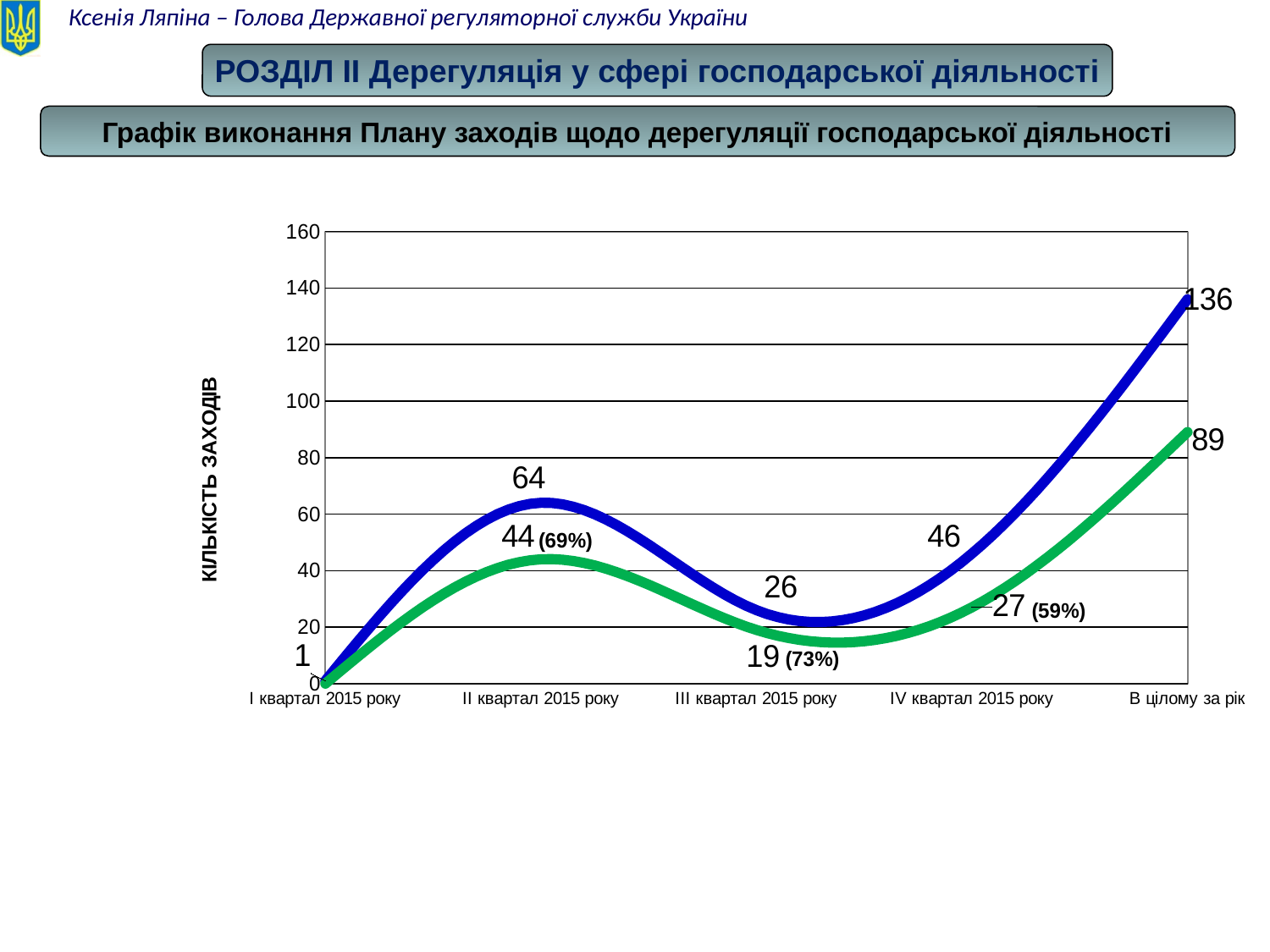
What is the label of the vertical axis? КІЛЬКІСТЬ ЗАХОДІВ What is the value of the green line for III квартал 2015 року? 19 What percentage is shown next to the green line's value for IV квартал 2015 року? 59% How many categories are shown on the x axis? 5 What is the value of the blue line for II квартал 2015 року? 64 Which category has the highest value on the blue line? В цілому за рік Which quarter has the lowest value on the green line among II, III and IV квартал 2015 року? III квартал 2015 року What is the value of the green line for В цілому за рік? 89 What type of chart is shown on the slide? line chart What is the value of the blue line for В цілому за рік? 136 What is the difference between the blue line and the green line for В цілому за рік? 47 Which is larger for IV квартал 2015 року: the blue line value or the green line value? the blue line value